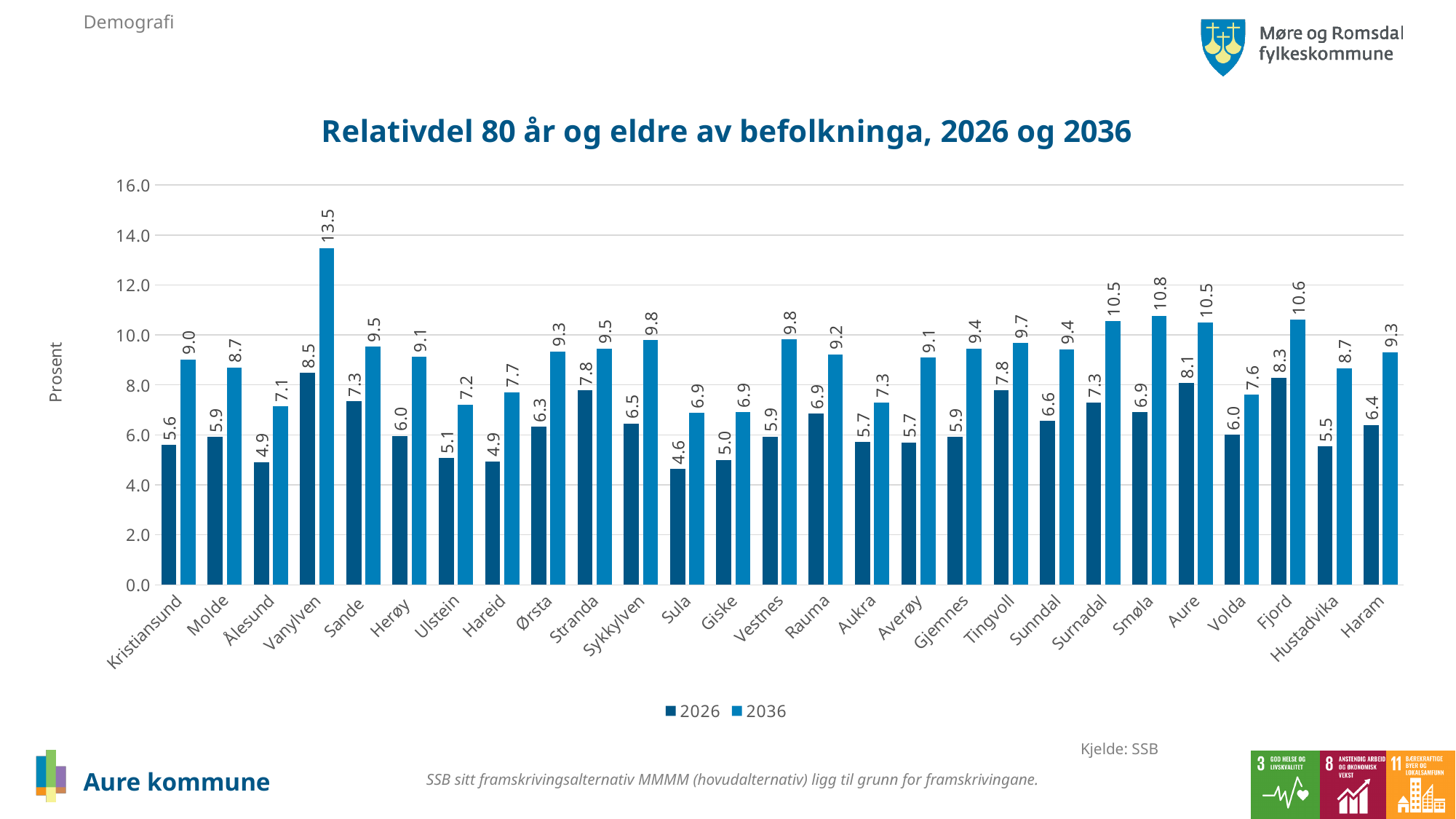
Which is larger: the 2036 value for Smøla or the 2036 value for Surnadal? Smøla What kind of chart is shown on the slide? Bar chart How many series does the legend list? 2 What is the difference between the 2036 and 2026 values for Vanylven? 5.0 What is the value for Hustadvika in the 2036 series? 8.7 How many municipalities are shown on the x axis? 27 What is the value for Aure in the 2036 series? 10.5 Which municipality has the highest value in the 2036 series? Vanylven What is the difference between the 2036 and 2026 values for Aure? 2.4 What is the value for Vanylven in the 2026 series? 8.5 Which municipality has the lowest value in the 2026 series? Sula Is the 2036 value for Vanylven greater or less than 12.0? greater